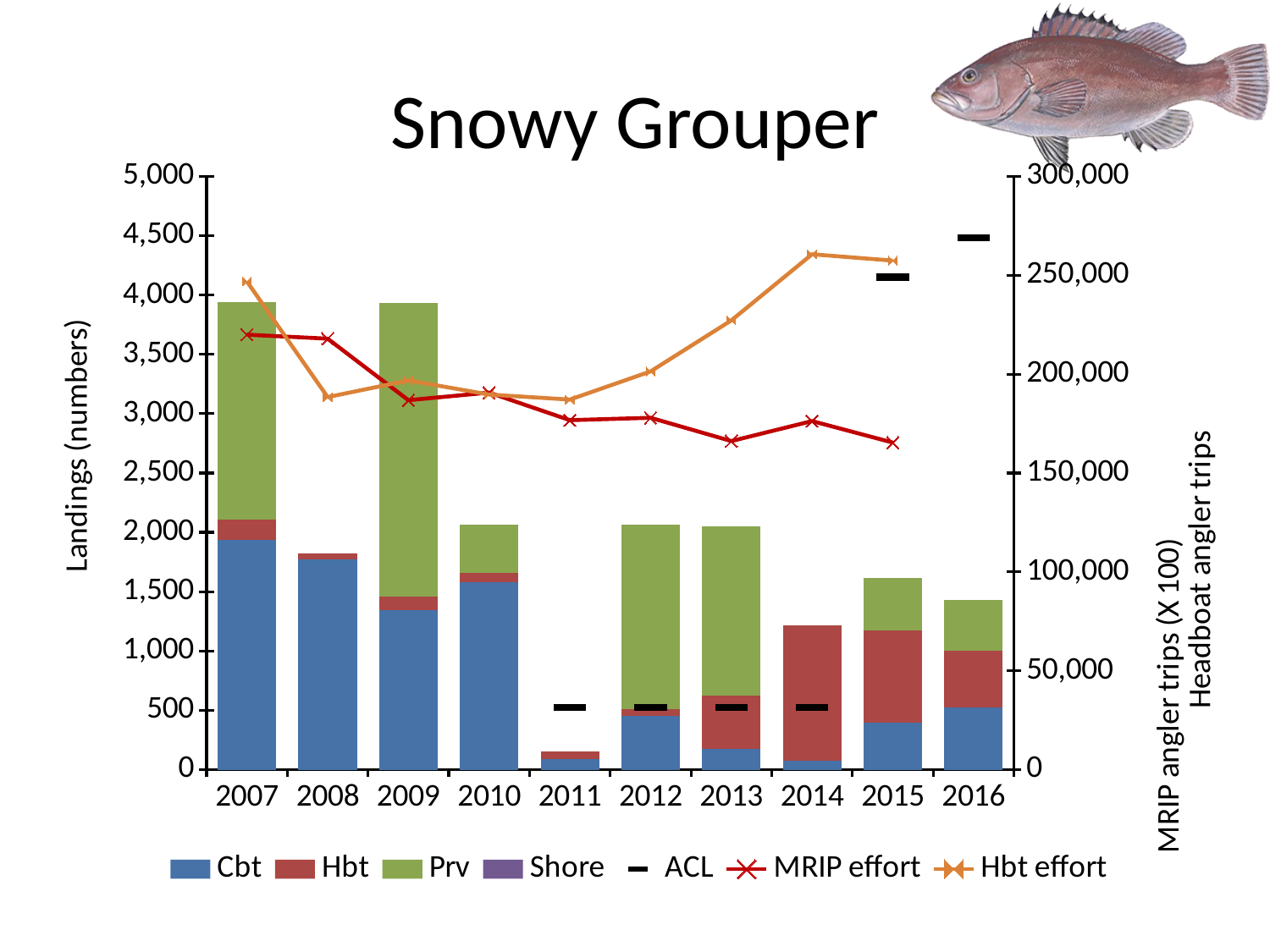
Is the total landings bar for 2016 greater or less than 1,000? greater How many years are shown on the x axis? 10 Is the Hbt effort value for 2014 greater or less than 250,000? greater Is the MRIP effort value for 2015 greater or less than 200,000? less What kind of chart is used for the landings data? bar chart (stacked) What is the title of the chart? Snowy Grouper How many entries does the legend list? 7 What is the label of the left vertical axis? Landings (numbers) Does the MRIP effort line generally rise or fall from 2007 to 2015? fall Which year has the lowest total landings bar? 2011